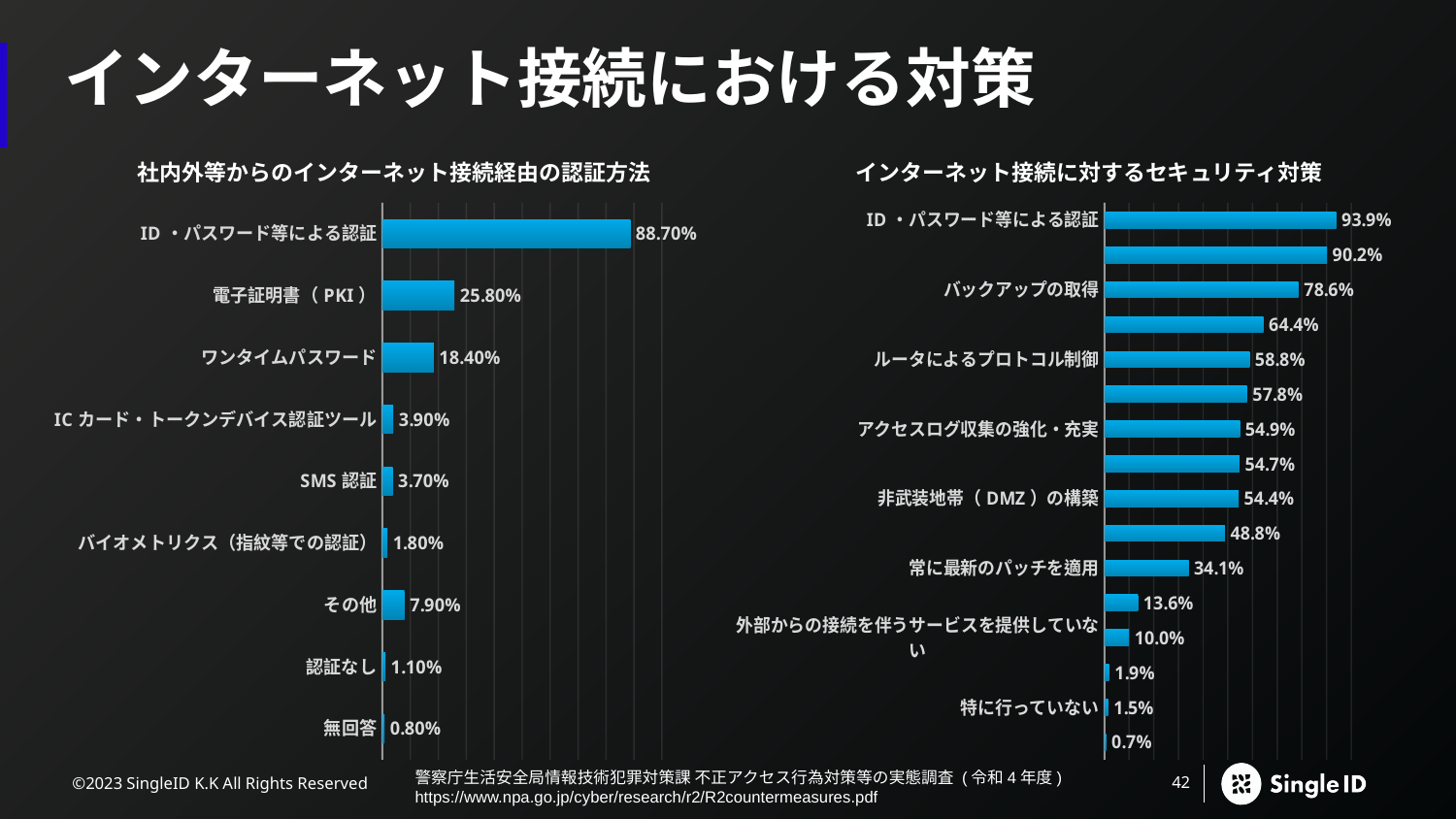
What kind of chart is the left chart titled 社内外等からのインターネット接続経由の認証方法? Bar chart In the left chart titled 社内外等からのインターネット接続経由の認証方法, which category has the lowest value? 無回答 In the left chart titled 社内外等からのインターネット接続経由の認証方法, what is the value for ワンタイムパスワード? 18.40% In the right chart titled インターネット接続に対するセキュリティ対策, what is the value for 常に最新のパッチを適用? 34.1% In the right chart titled インターネット接続に対するセキュリティ対策, which category has the highest value? ID・パスワード等による認証 In the right chart titled インターネット接続に対するセキュリティ対策, which is larger: ルータによるプロトコル制御 or 特に行っていない? ルータによるプロトコル制御 In the left chart titled 社内外等からのインターネット接続経由の認証方法, what is the value for ID・パスワード等による認証? 88.70% In the right chart titled インターネット接続に対するセキュリティ対策, what is the value for バックアップの取得? 78.6% In the left chart titled 社内外等からのインターネット接続経由の認証方法, what is the difference between 電子証明書（PKI） and ワンタイムパスワード? 7.40% In the left chart titled 社内外等からのインターネット接続経由の認証方法, which is larger: IC カード・トークンデバイス認証ツール or その他? その他 In the left chart titled 社内外等からのインターネット接続経由の認証方法, how many categories are shown? 9 In the right chart titled インターネット接続に対するセキュリティ対策, what is the difference between ID・パスワード等による認証 and バックアップの取得? 15.3%